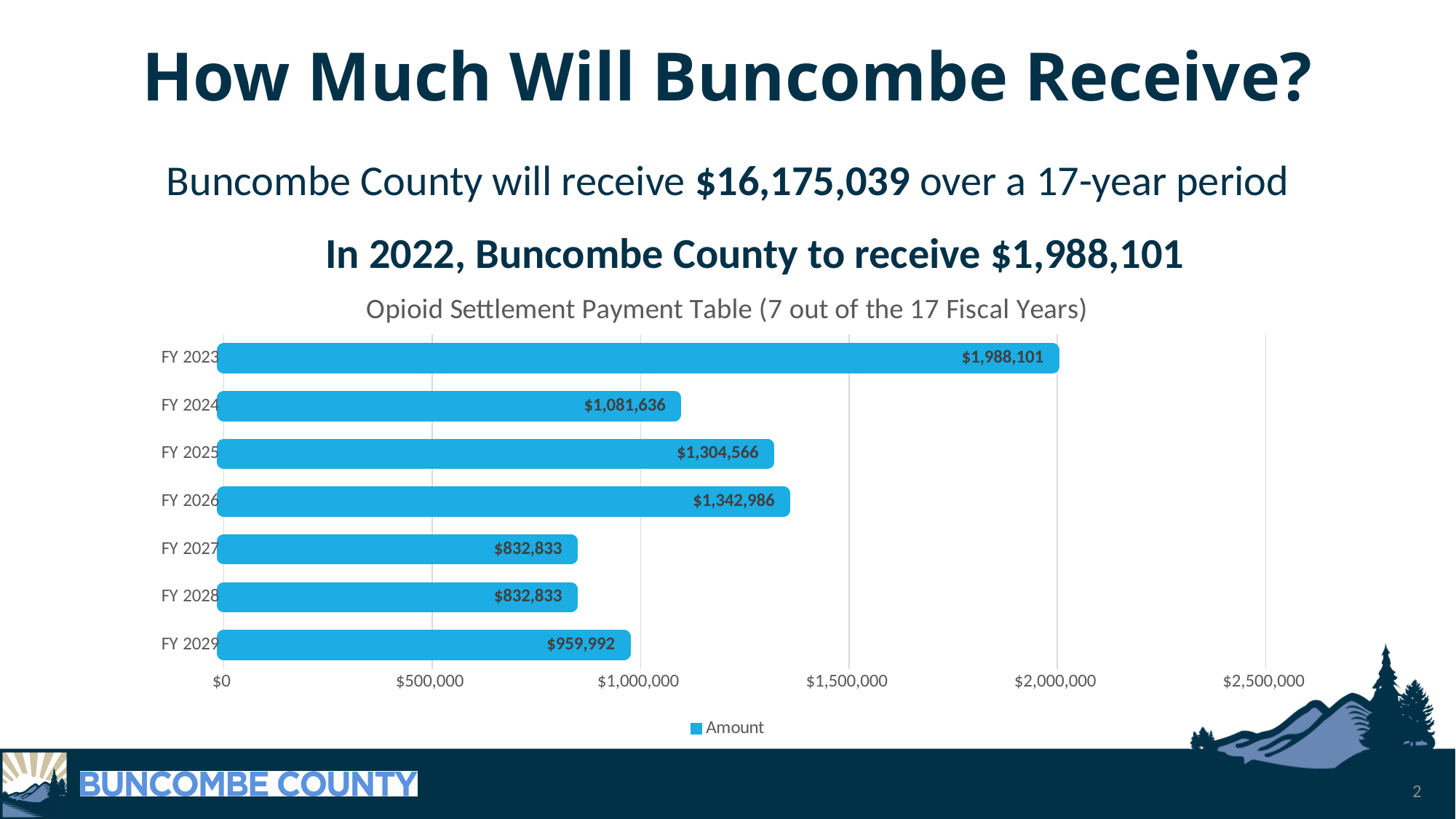
What is the title of the chart? Opioid Settlement Payment Table (7 out of the 17 Fiscal Years) What is the value for FY 2023? $1,988,101 How many series does the legend list? 1 What is the difference between the amounts for FY 2026 and FY 2025? $38,420 What kind of chart is shown on the slide? bar chart Which fiscal year has the highest amount? FY 2023 What is the value for FY 2029? $959,992 What is the difference between the amounts for FY 2023 and FY 2024? $906,465 Which is larger, the amount for FY 2025 or FY 2026? FY 2026 What is the value for FY 2026? $1,342,986 How many fiscal years are shown in the chart? 7 Is the value for FY 2029 greater or less than $1,000,000? less